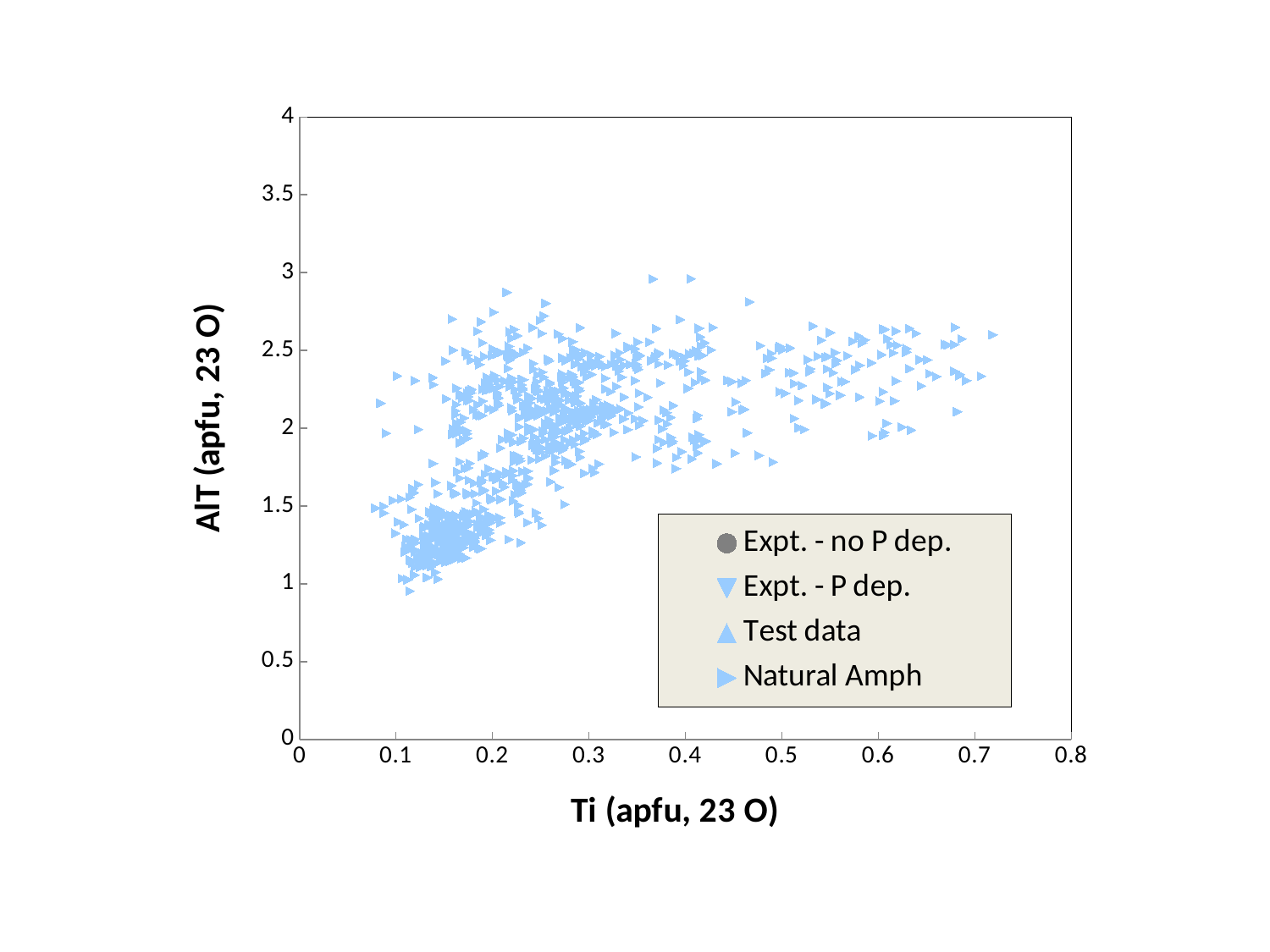
Is the highest plotted AlT value greater or less than 3.5? less What is the label of the x axis? Ti (apfu, 23 O) How many series does the legend list? 4 What kind of chart is shown on the slide? scatter chart Which legend entry is shown with a grey circle marker? Expt. - no P dep. Is the largest plotted Ti value greater or less than 0.8? less Is the lowest plotted AlT value greater or less than 0.5? greater Do the AlT values generally rise or fall as Ti increases along the x axis? rise